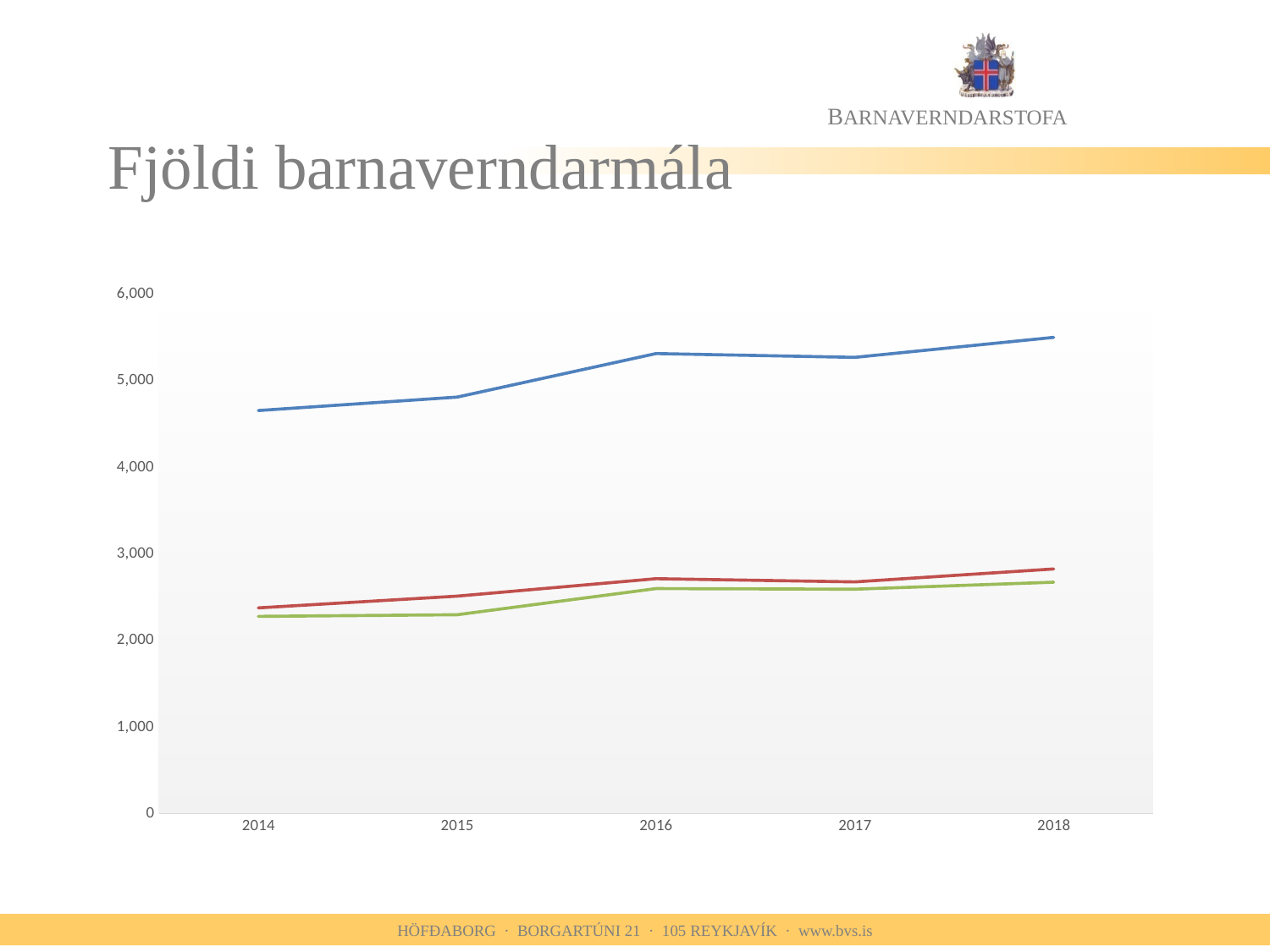
In 2018, which line has the higher value, the blue line or the red line? blue line Is the value of the green line in 2014 greater or less than 2,000? greater Is the value of the blue line in 2018 greater or less than 5,000? greater What kind of chart is shown on the slide? line chart Is the value of the blue line in 2014 greater or less than 5,000? less What is the title of the slide's chart? Fjöldi barnaverndarmála How many lines are plotted on the chart? 3 Which year is the first on the x axis? 2014 In which year does the blue line reach its highest value? 2018 How many years are shown on the x axis of the chart? 5 Does the blue line rise or fall overall from 2014 to 2018? rise